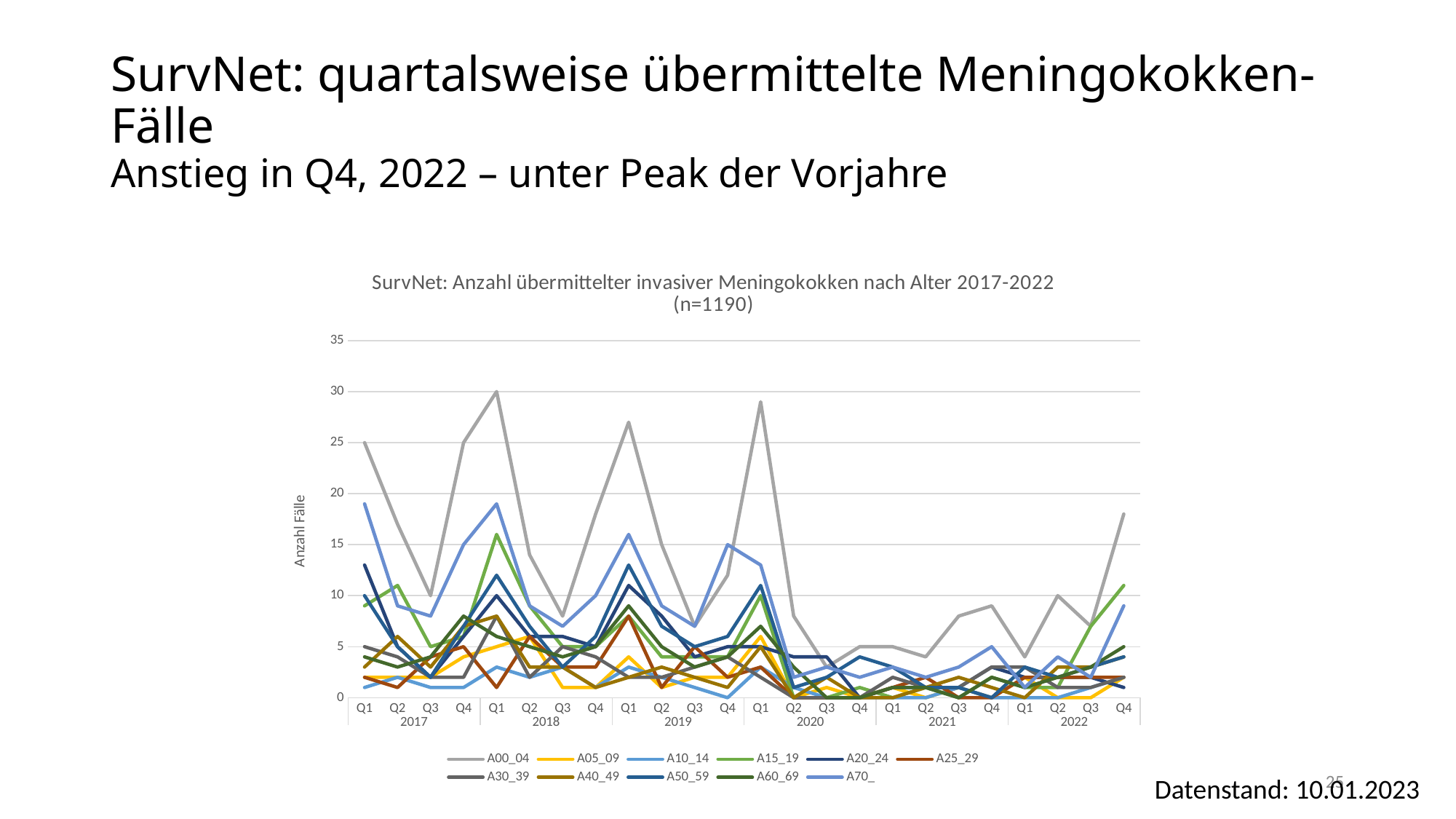
Is the value for A20_24 in Q1 2017 greater or less than 10? greater Does the A00_04 series rise or fall from Q1 2022 to Q4 2022? rise Is the value for A70_ in Q4 2019 greater or less than 10? greater What kind of chart is shown on the slide? line chart Is the value for A00_04 in Q4 2022 greater or less than 15? greater Which series reaches the highest value anywhere in the chart? A00_04 How many quarterly data points are plotted along the x axis of the chart? 24 What is the label of the y axis of the chart? Anzahl Fälle What total number of cases (n) is given in the chart title? n=1190 How many series does the legend of the chart list? 11